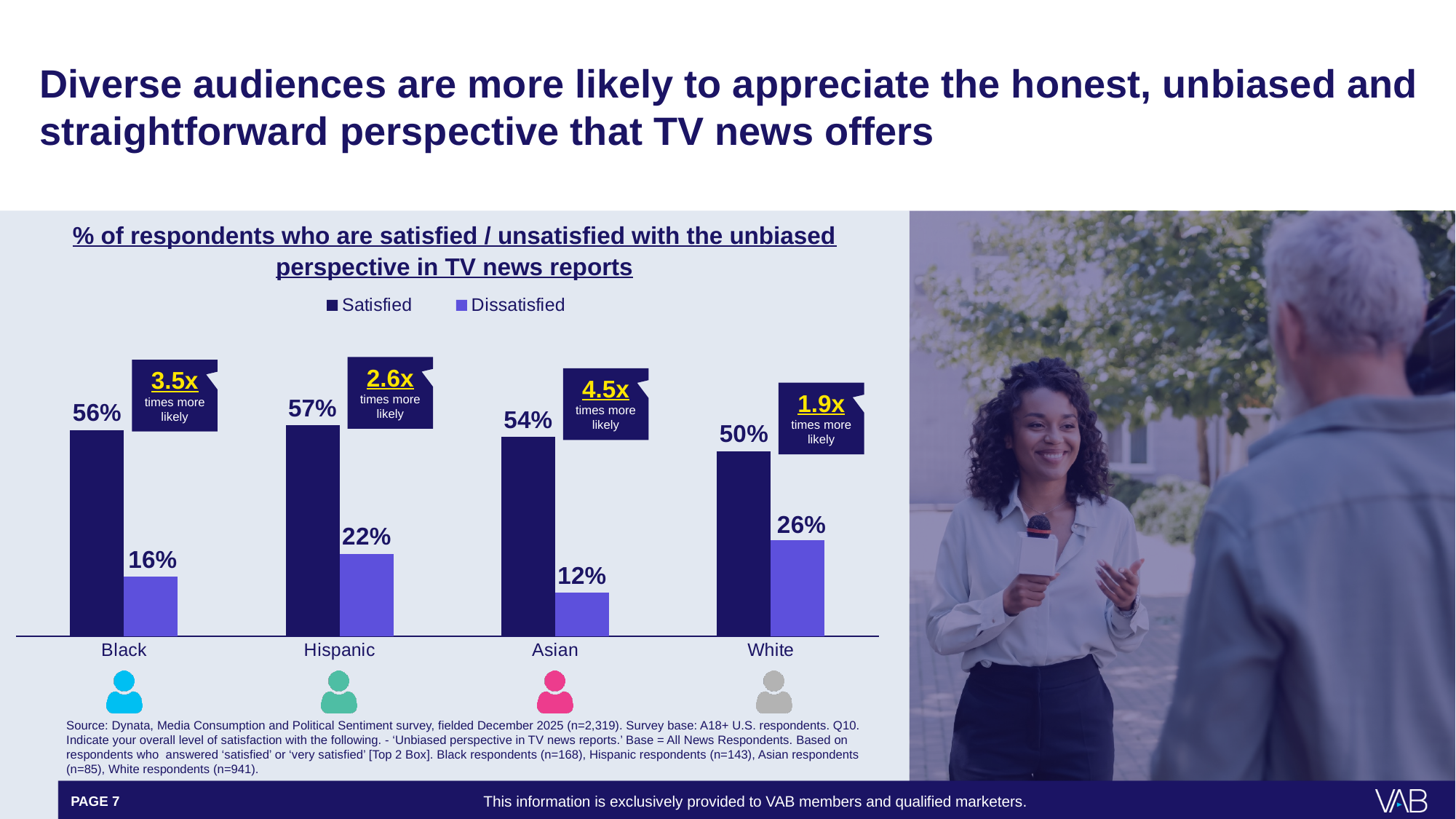
Which group has the lowest Dissatisfied value? Asian What percentage of Asian respondents are dissatisfied? 12% What 'times more likely' multiplier is shown above the Asian bars? 4.5x What kind of chart is shown? Bar chart What percentage of Black respondents are satisfied with the unbiased perspective in TV news reports? 56% What is the difference between the Satisfied and Dissatisfied values for Hispanic respondents? 35 percentage points How many groups are shown on the x axis? 4 What percentage of White respondents are dissatisfied? 26% What is the title of the chart? % of respondents who are satisfied / unsatisfied with the unbiased perspective in TV news reports Which group has the highest Satisfied value? Hispanic Which is larger: the Dissatisfied value for White respondents or for Black respondents? White How many series does the legend list? 2